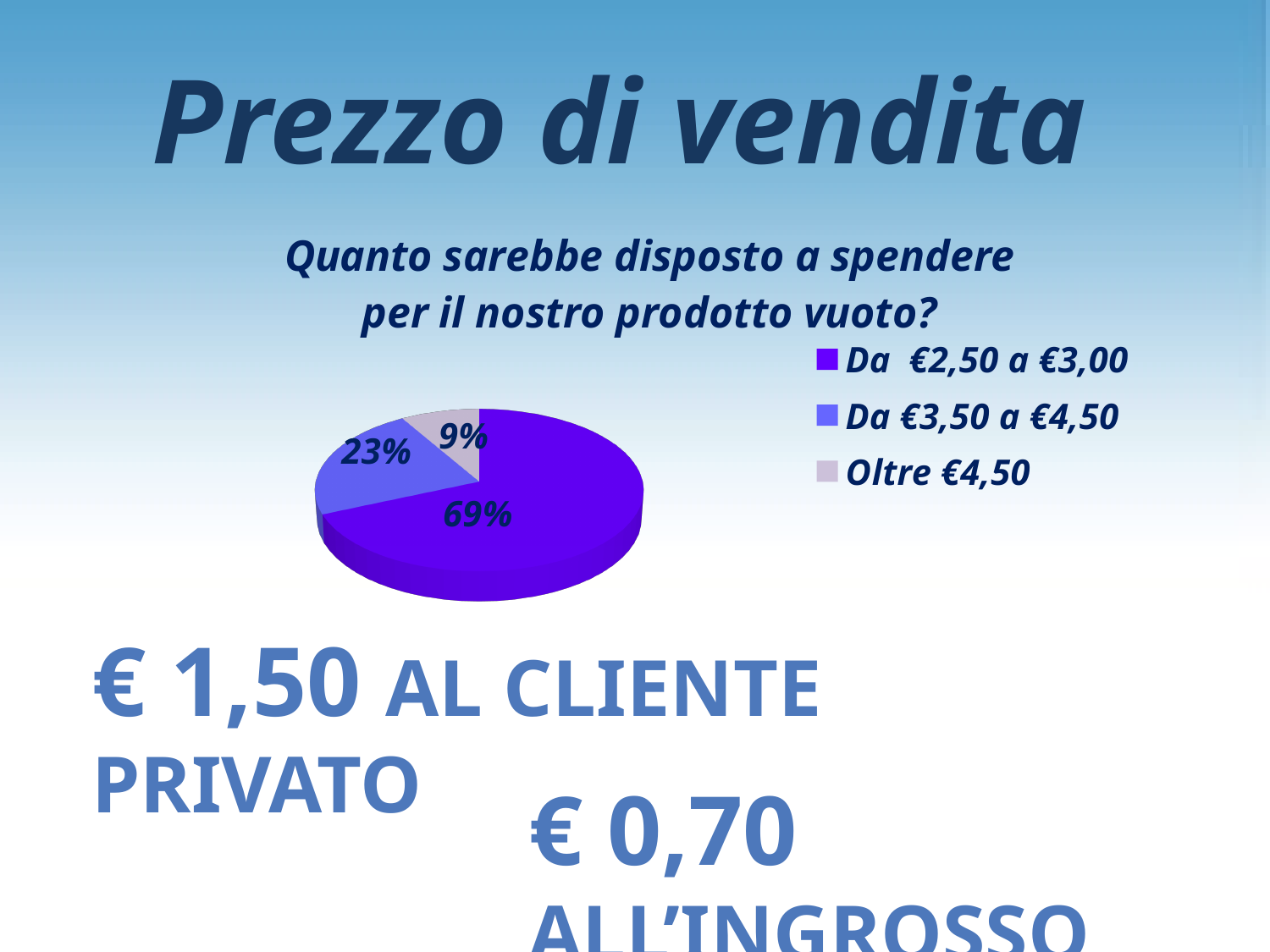
What is the difference in percentage points between the 'Da €3,50 a €4,50' slice and the 'Oltre €4,50' slice? 14 Which category has the smallest slice of the pie? Oltre €4,50 How many slices does the pie chart have? 3 How many entries does the legend list? 3 What kind of chart is shown on the slide? pie chart Which category has the largest slice of the pie? Da €2,50 a €3,00 What is the difference in percentage points between the 'Da €2,50 a €3,00' slice and the 'Da €3,50 a €4,50' slice? 46 What share of the pie does the 'Oltre €4,50' slice represent? 9% What share of the pie does the 'Da €3,50 a €4,50' slice represent? 23% What question is posed as the title above the pie chart? Quanto sarebbe disposto a spendere per il nostro prodotto vuoto? Which is larger: the 'Da €3,50 a €4,50' slice or the 'Oltre €4,50' slice? Da €3,50 a €4,50 What share of the pie does the 'Da €2,50 a €3,00' slice represent? 69%